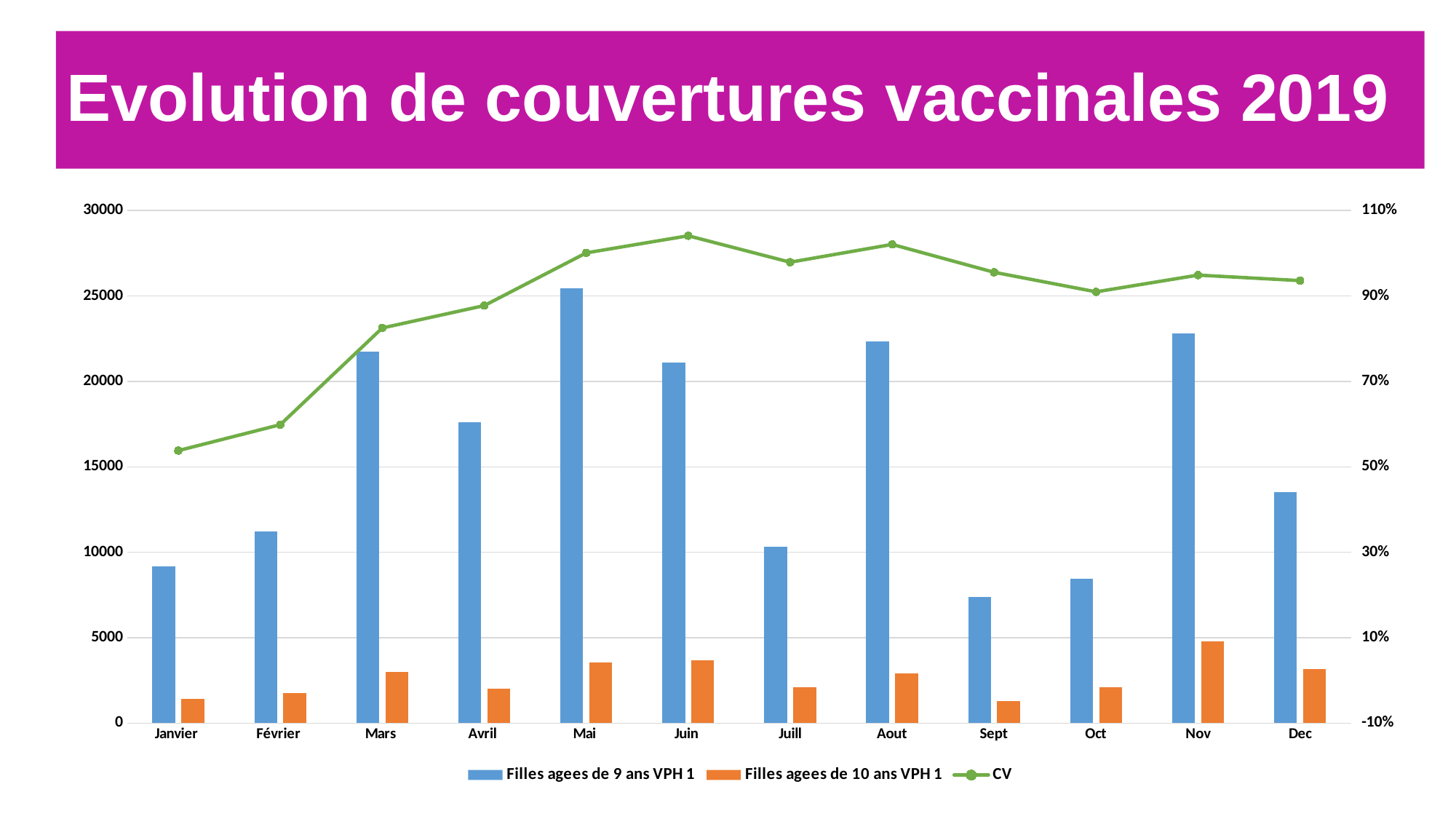
Is the CV value in Mars greater or less than 70%? greater What is the title of the chart on the slide? Evolution de couvertures vaccinales 2019 What kind of chart is shown on the slide? A combination of a bar chart and a line chart How many series does the legend list? 3 In which month is the CV line at its lowest point? Janvier Which month has the larger bar for 'Filles agees de 9 ans VPH 1', Mai or Avril? Mai In which month is the bar for 'Filles agees de 9 ans VPH 1' the lowest? Sept In which month is the bar for 'Filles agees de 9 ans VPH 1' the highest? Mai Is the value for 'Filles agees de 9 ans VPH 1' in Sept greater or less than 10000? less Is the value for 'Filles agees de 9 ans VPH 1' in Mars greater or less than 20000? greater How many months are shown on the x axis? 12 In which month is the bar for 'Filles agees de 10 ans VPH 1' the highest? Nov